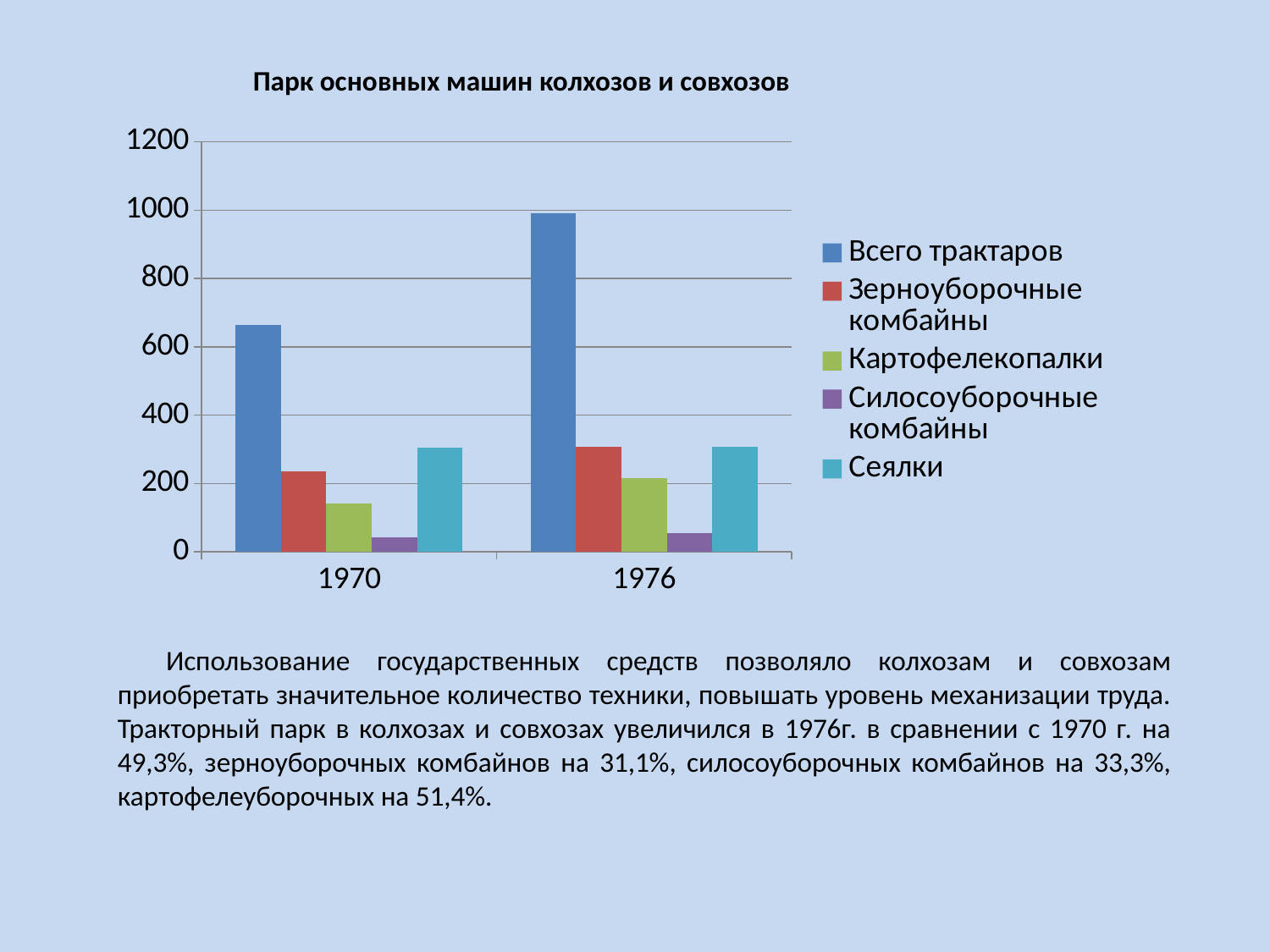
Is the value for Силосоуборочные комбайны in 1976 greater or less than 200? less Does the value for Зерноуборочные комбайны rise or fall from 1970 to 1976? rise What is the title of the chart? Парк основных машин колхозов и совхозов Which series has the highest value in 1976? Всего трактаров What kind of chart is shown on the slide? bar chart Which is larger: Всего трактаров in 1970 or Всего трактаров in 1976? 1976 How many categories are shown on the x axis? 2 Is the value for Всего трактаров in 1970 greater or less than 800? less How many series does the legend list? 5 Which series has the lowest value in 1970? Силосоуборочные комбайны Is the value for Всего трактаров in 1976 greater or less than 800? greater